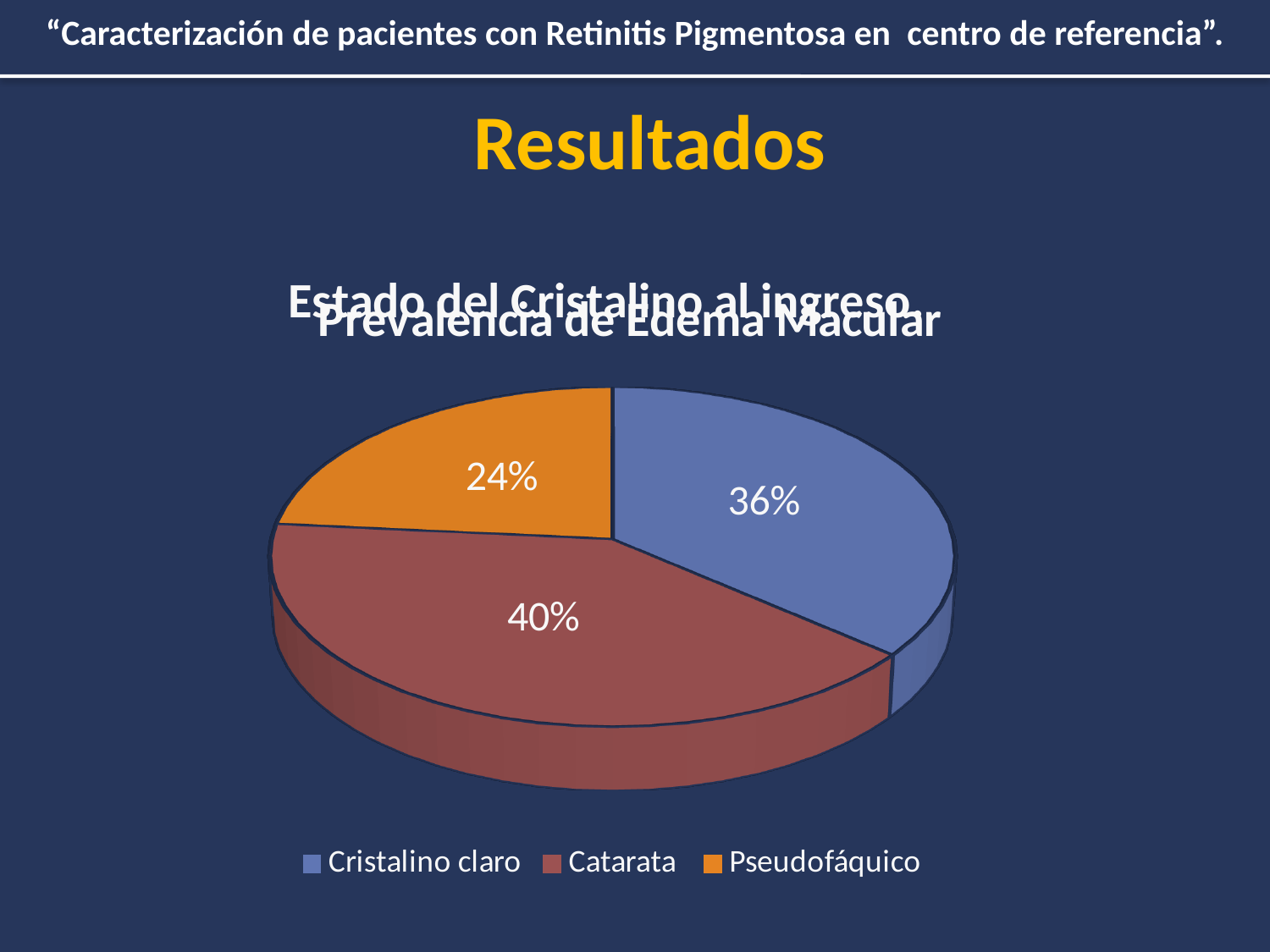
How many entries does the legend list? 3 What is the difference in percentage points between Catarata and Pseudofáquico? 16 What percentage of the pie is Cristalino claro? 36% How many slices does the pie chart have? 3 What colour is the Pseudofáquico slice? orange What percentage of the pie is Pseudofáquico? 24% What kind of chart is shown on the slide? pie chart Which category has the largest slice of the pie? Catarata What percentage of the pie is Catarata? 40% Which is larger, the slice for Cristalino claro or the slice for Pseudofáquico? Cristalino claro Which category has the smallest slice of the pie? Pseudofáquico What is the difference in percentage points between Catarata and Cristalino claro? 4